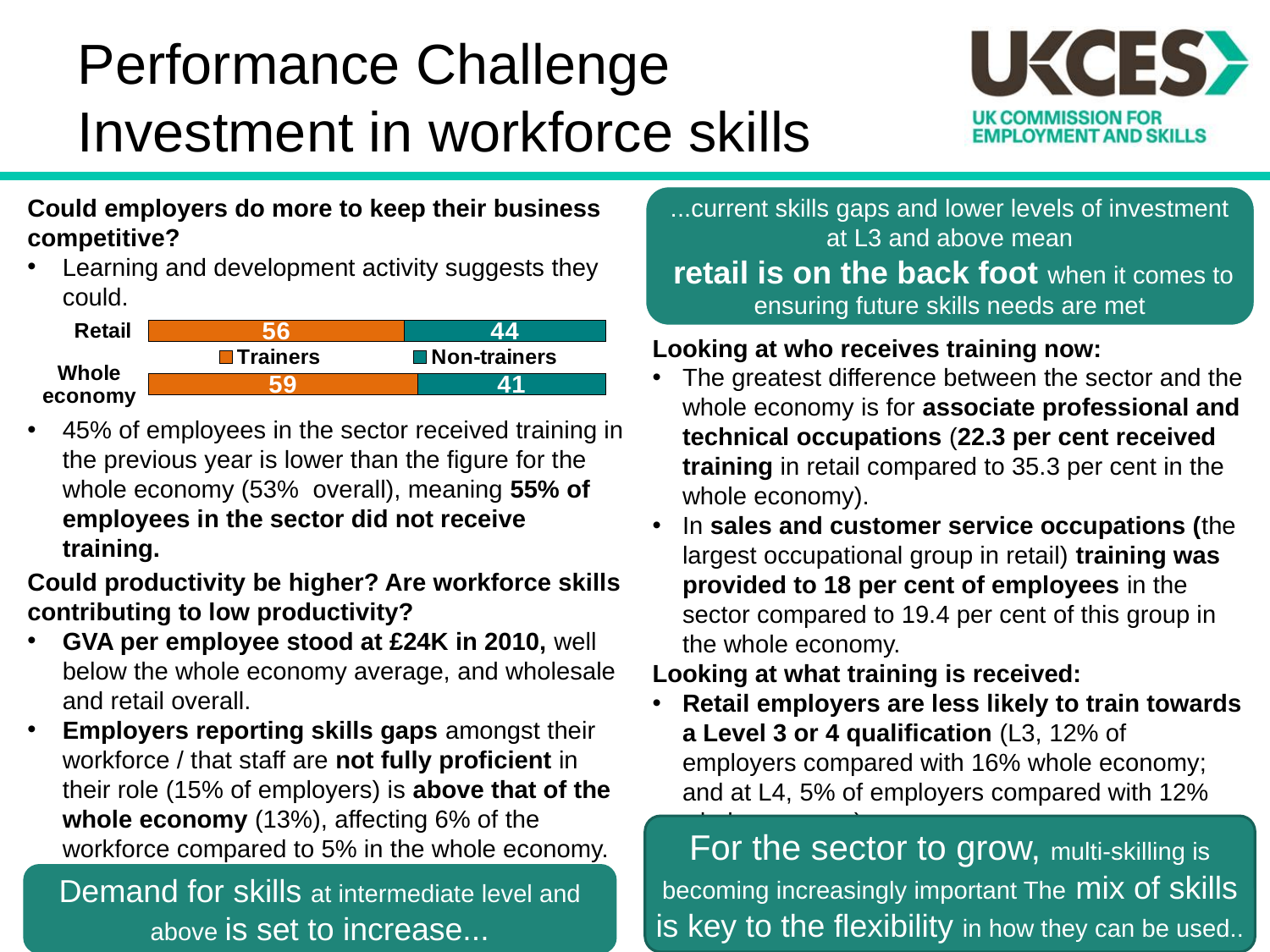
How many categories are shown in the chart? 2 Which category has the higher Trainers value, Retail or Whole economy? Whole economy What is the value for Non-trainers in the Whole economy bar? 41 What is the difference between the Trainers and Non-trainers values in the Retail bar? 12 Which category has the higher Non-trainers value, Retail or Whole economy? Retail How many series does the chart legend list? 2 What is the total of the Retail stacked bar? 100 What is the difference between the Trainers values for Whole economy and Retail? 3 What is the value for Trainers in the Whole economy bar? 59 What kind of chart is shown on the slide? Stacked bar chart What is the value for Trainers in the Retail bar? 56 What is the value for Non-trainers in the Retail bar? 44